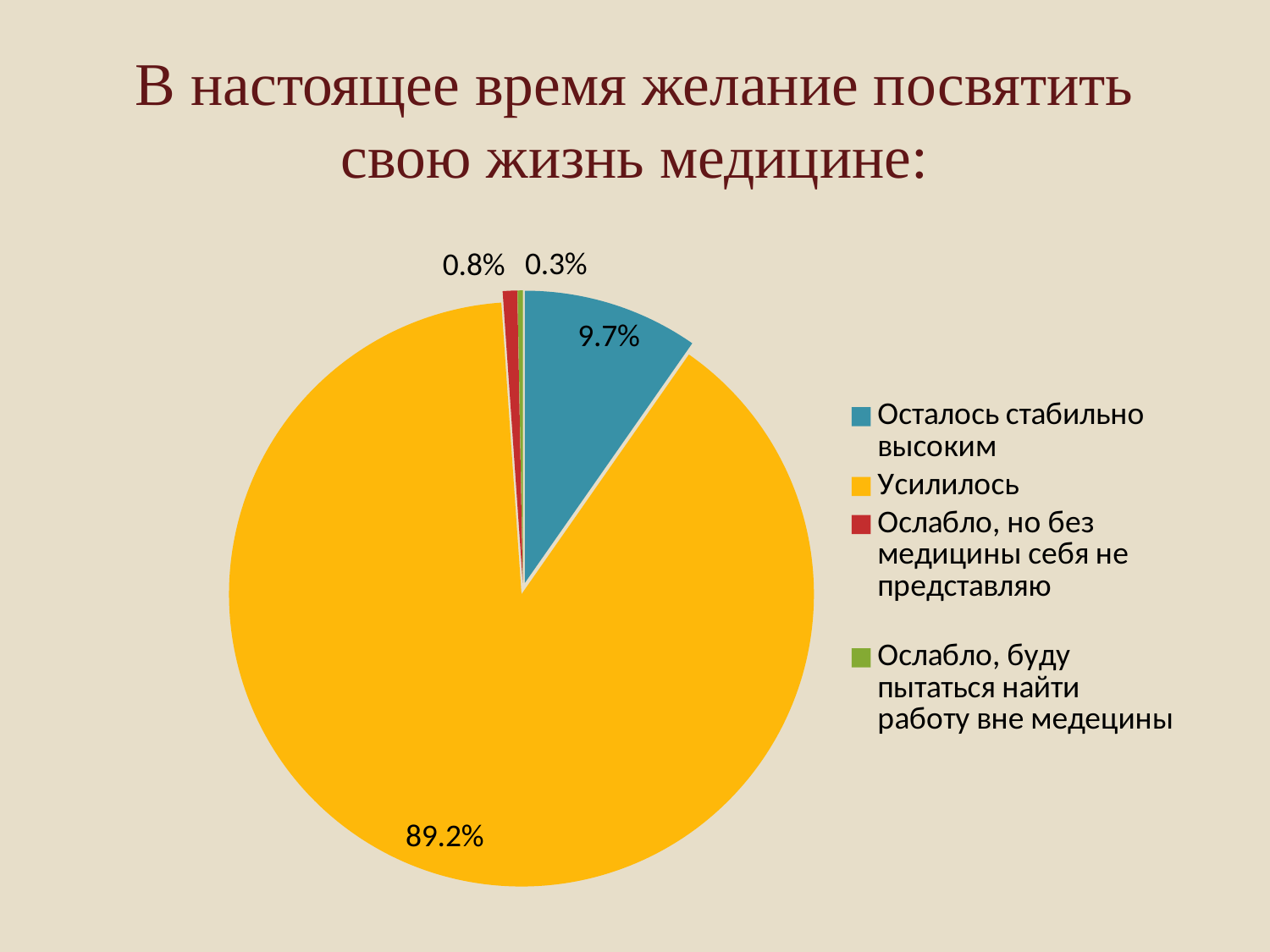
What colour is the slice for "Усилилось"? yellow What share of the pie does "Ослабло, буду пытаться найти работу вне медецины" have? 0.3% What share of the pie does "Усилилось" have? 89.2% How many categories does the legend list? 4 What share of the pie does "Ослабло, но без медицины себя не представляю" have? 0.8% What kind of chart is shown on the slide? pie chart Which category has the largest slice of the pie? Усилилось What is the difference between the shares for "Усилилось" and "Осталось стабильно высоким"? 79.5% What is the title of the slide above the chart? В настоящее время желание посвятить свою жизнь медицине: Which is larger: the share for "Осталось стабильно высоким" or the share for "Ослабло, но без медицины себя не представляю"? Осталось стабильно высоким What share of the pie does "Осталось стабильно высоким" have? 9.7% Which category has the smallest slice of the pie? Ослабло, буду пытаться найти работу вне медецины